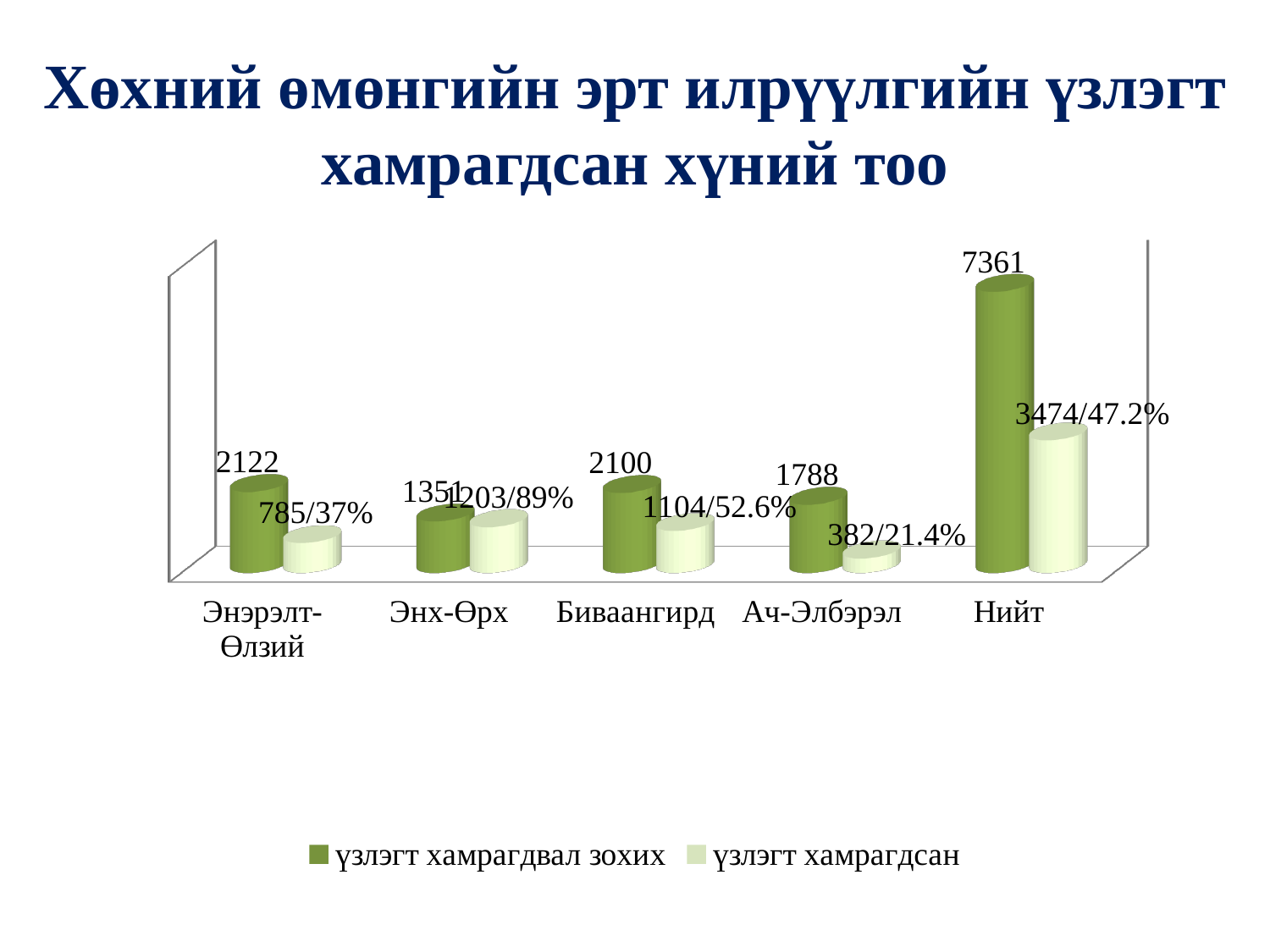
How many series does the legend list? 2 What is the data label for 'үзлэгт хамрагдсан' for Ач-Элбэрэл? 382/21.4% What type of chart is shown on the slide? bar chart What is the value of 'үзлэгт хамрагдвал зохих' for Нийт? 7361 What is the value of 'үзлэгт хамрагдвал зохих' for Энэрэлт-Өлзий? 2122 Which category has the highest value for 'үзлэгт хамрагдвал зохих'? Нийт What is the data label for 'үзлэгт хамрагдсан' for Биваангирд? 1104/52.6% How many categories are shown on the x axis? 5 What is the name of the second series in the legend? үзлэгт хамрагдсан Which is larger: 'үзлэгт хамрагдвал зохих' for Биваангирд or for Ач-Элбэрэл? Биваангирд Excluding Нийт, which category has the lowest value for 'үзлэгт хамрагдвал зохих'? Энх-Өрх What is the difference between 'үзлэгт хамрагдвал зохих' and 'үзлэгт хамрагдсан' for Энэрэлт-Өлзий? 1337